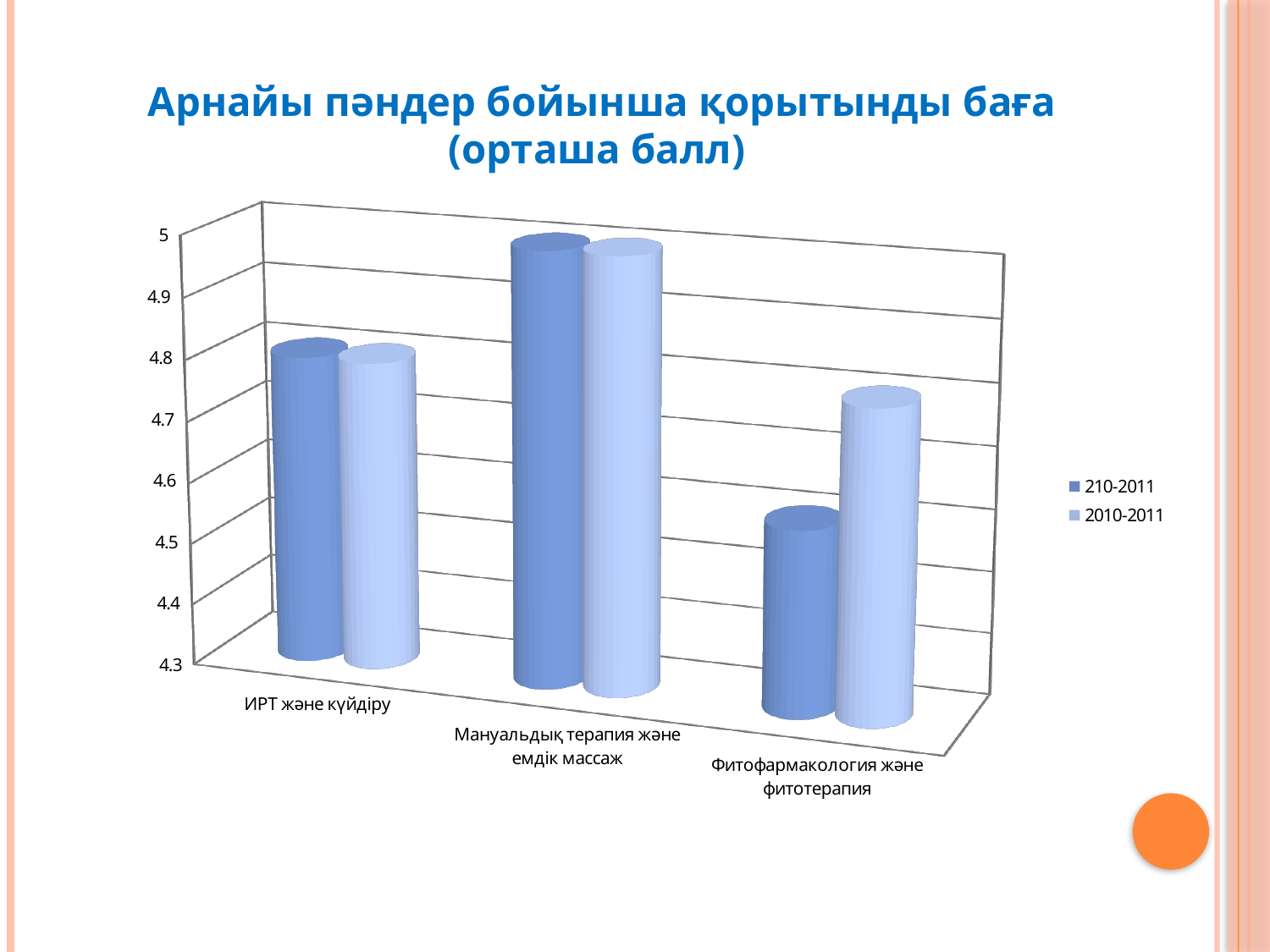
Which category has the highest value for the 210-2011 series? Мануальдық терапия және емдік массаж For Фитофармакология және фитотерапия, which series has the larger value: 210-2011 or 2010-2011? 2010-2011 Is the 210-2011 value for Мануальдық терапия және емдік массаж greater or less than 4.9? greater What kind of chart is shown on the slide? bar chart Is the 210-2011 value for Фитофармакология және фитотерапия greater or less than 4.7? less Is the 2010-2011 value for Фитофармакология және фитотерапия greater or less than 4.6? greater How many series does the chart legend list? 2 How many categories are shown on the x axis of the chart? 3 Which category has the lowest value for the 210-2011 series? Фитофармакология және фитотерапия What is the title of the chart on the slide? Арнайы пәндер бойынша қорытынды баға (орташа балл)